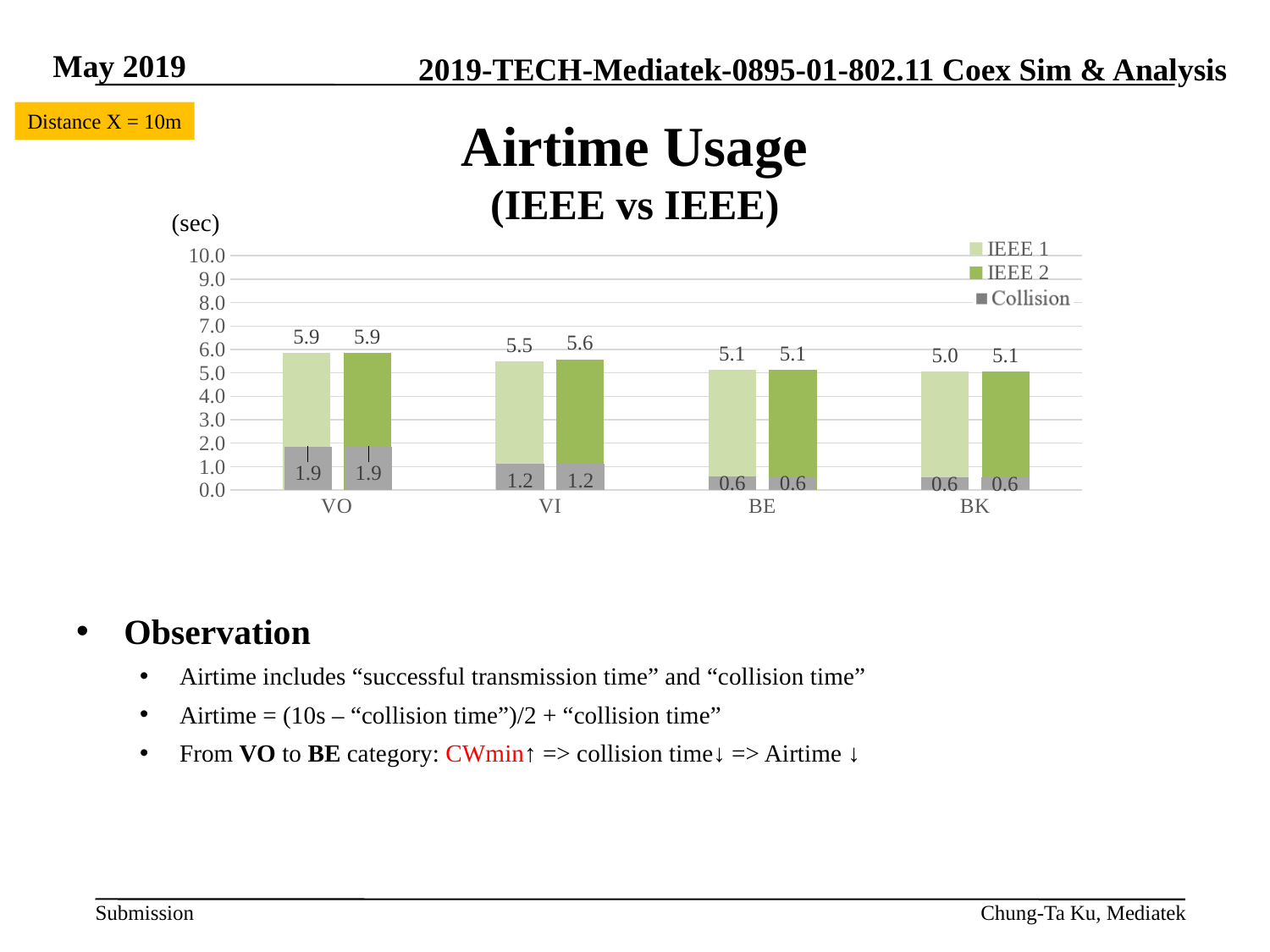
Which category has the lowest IEEE 1 value? BK Is the IEEE 1 value for VO greater or less than 5.0? greater How many categories are shown on the x axis? 4 What is the Collision value for the BE category? 0.6 How many series does the legend list? 3 What is the IEEE 2 airtime value for the VI category? 5.6 What is the difference between the IEEE 1 value for VO and the IEEE 1 value for BK? 0.9 What is the IEEE 1 airtime value for the VO category? 5.9 Which category has the highest IEEE 1 value? VO What is the difference between the Collision value for VO and the Collision value for VI? 0.7 Which is larger, the IEEE 2 value for VI or the IEEE 2 value for BE? VI What kind of chart is shown on the slide? bar chart